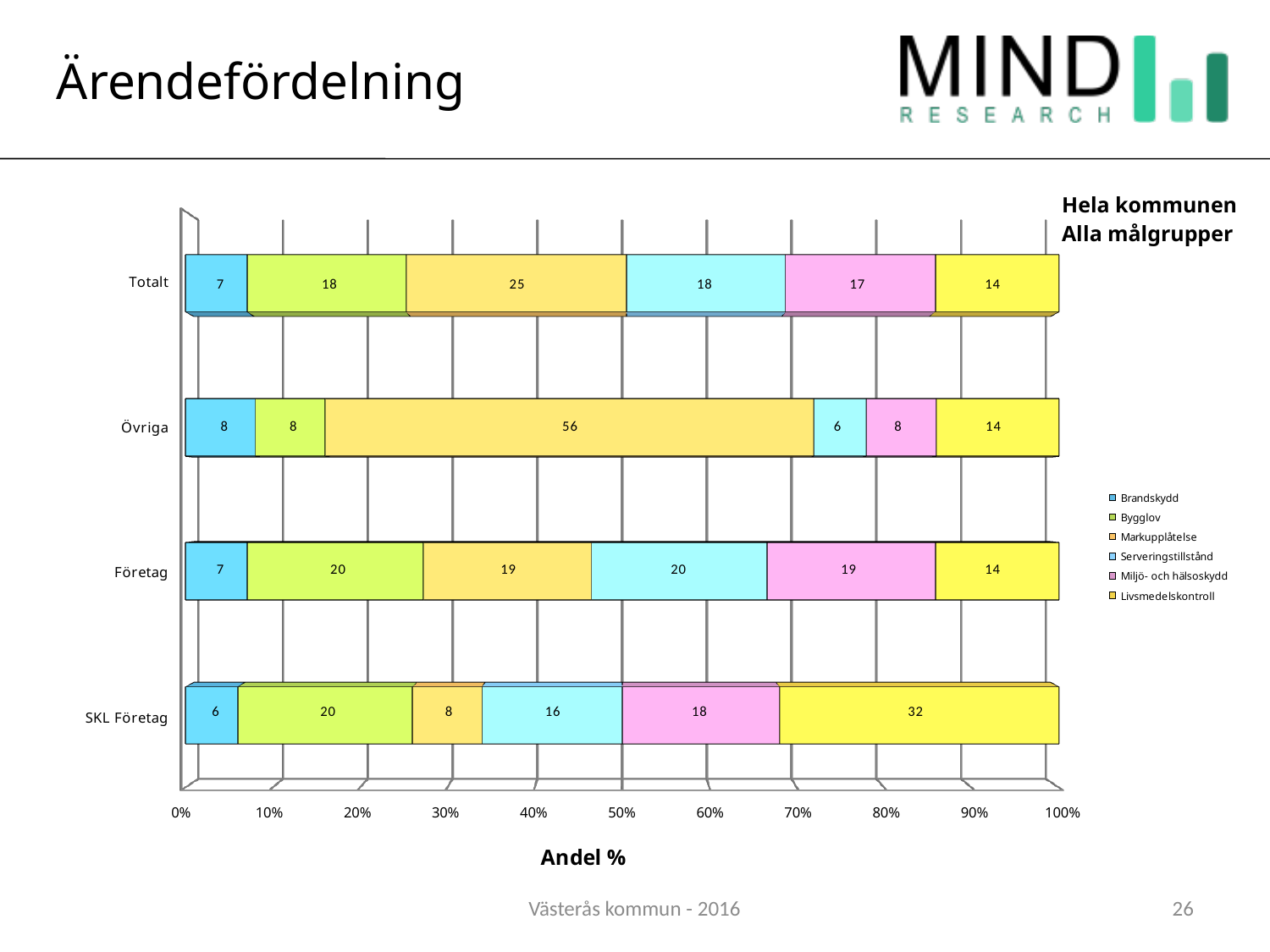
How many categories are shown on the vertical axis of the chart? 4 How many series does the legend list? 6 Which is larger: the Livsmedelskontroll value for SKL Företag or for Företag? SKL Företag Which category has the lowest value for Brandskydd? SKL Företag What is the total of the stacked bar for Övriga? 100 What is the value of Markupplåtelse for Övriga? 56 What is the value of Livsmedelskontroll for SKL Företag? 32 What kind of chart is shown on the slide? Stacked bar chart What is the value of Bygglov for Totalt? 18 Which category has the highest value for Markupplåtelse? Övriga What is the label of the horizontal axis? Andel % What is the difference between the Markupplåtelse value for Övriga and for Totalt? 31